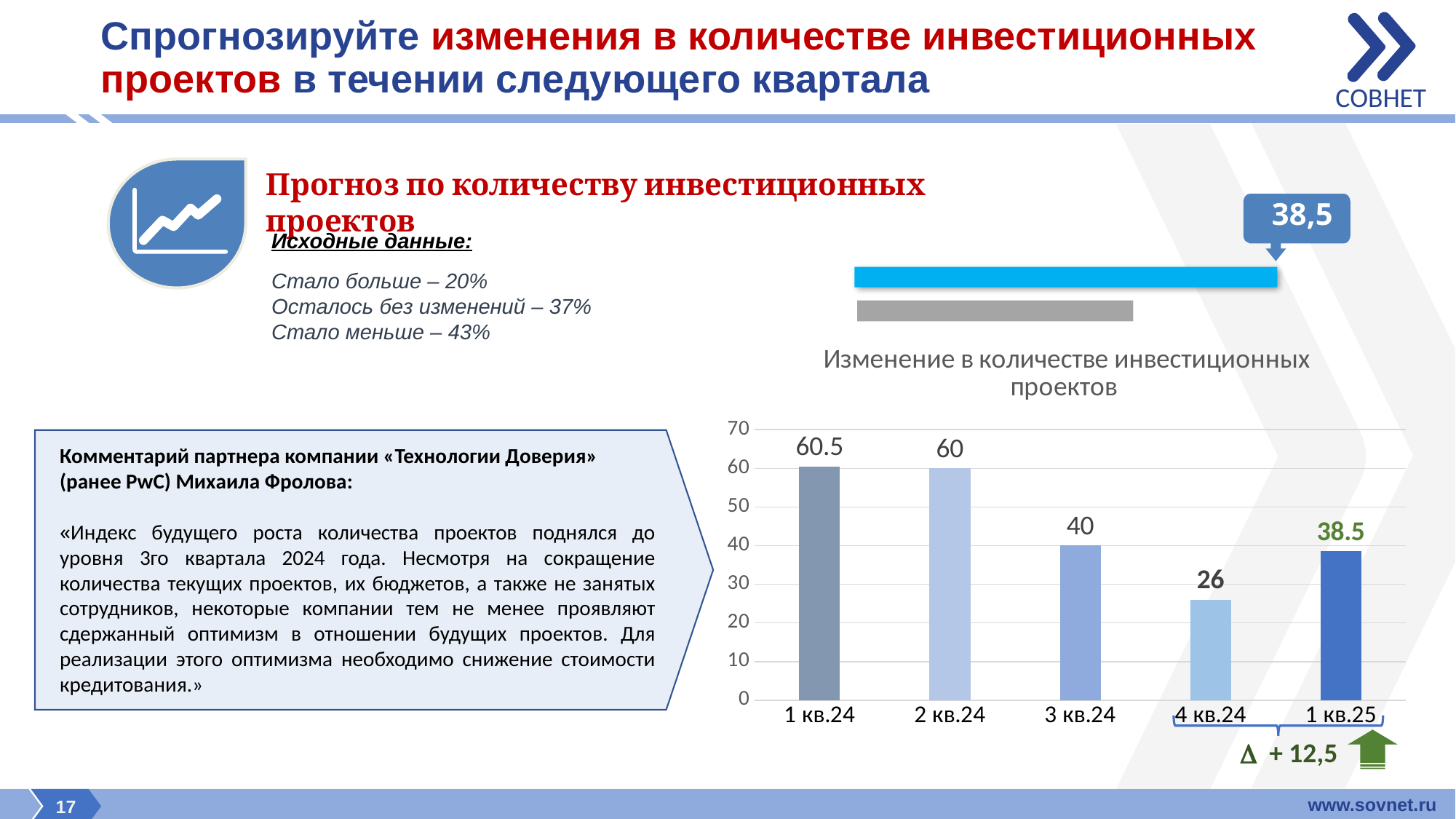
Which quarter has the highest value in the chart "Изменение в количестве инвестиционных проектов"? 1 кв.24 What is the value for 1 кв.25 in the chart "Изменение в количестве инвестиционных проектов"? 38.5 What is the value for 3 кв.24 in the chart "Изменение в количестве инвестиционных проектов"? 40 Is the value for 2 кв.24 in the chart "Изменение в количестве инвестиционных проектов" greater or less than 50? greater What is the value for 1 кв.24 in the chart "Изменение в количестве инвестиционных проектов"? 60.5 Do the values in the chart "Изменение в количестве инвестиционных проектов" rise or fall from 1 кв.24 to 4 кв.24? fall Which quarter has the lowest value in the chart "Изменение в количестве инвестиционных проектов"? 4 кв.24 How many quarters are shown on the x axis of the chart "Изменение в количестве инвестиционных проектов"? 5 What is the difference between the values for 1 кв.25 and 4 кв.24 in the chart "Изменение в количестве инвестиционных проектов"? 12.5 Which is larger in the chart "Изменение в количестве инвестиционных проектов": the value for 3 кв.24 or the value for 1 кв.25? 3 кв.24 What is the value for 4 кв.24 in the chart "Изменение в количестве инвестиционных проектов"? 26 What kind of chart is "Изменение в количестве инвестиционных проектов"? bar chart